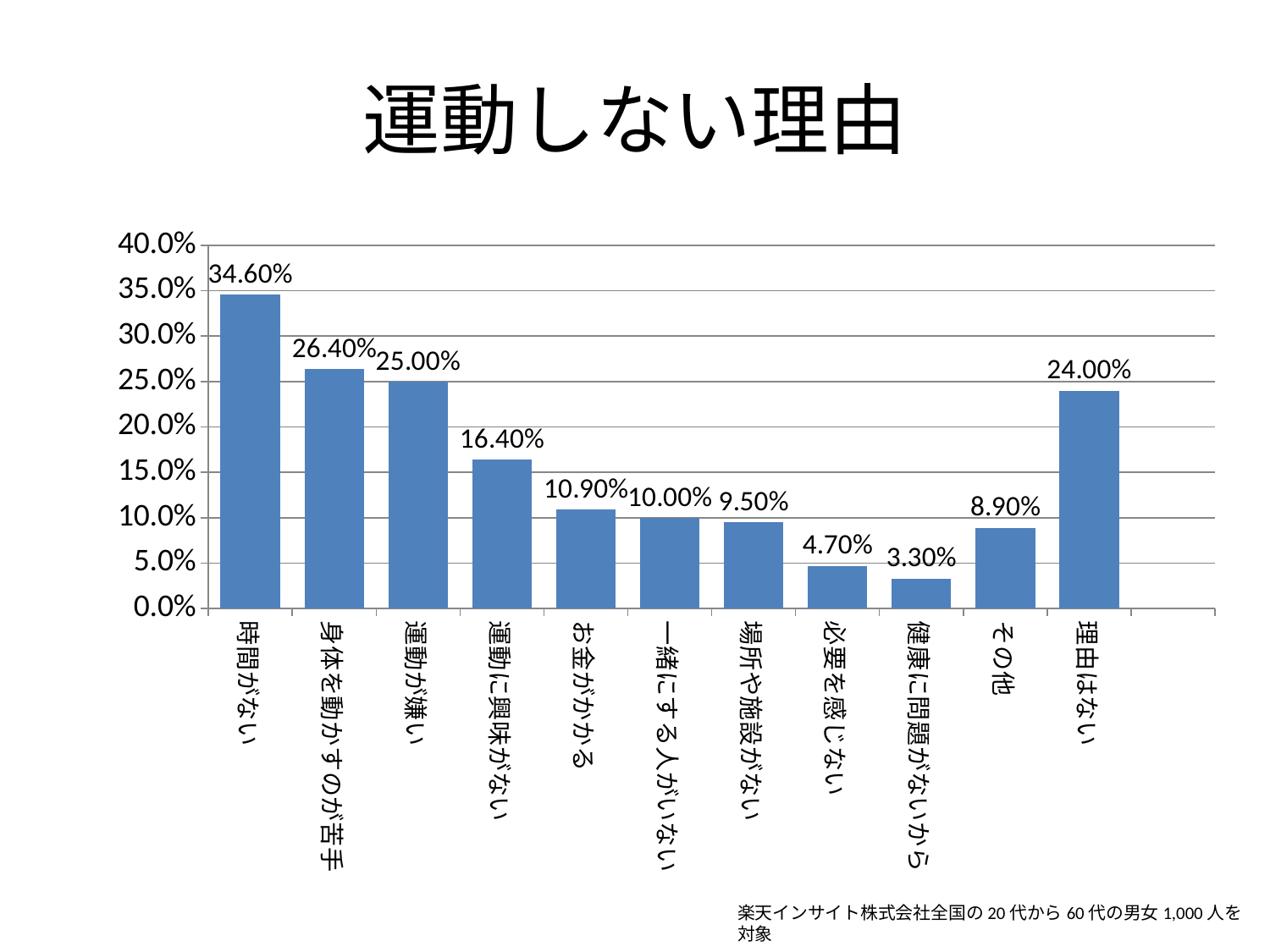
What is the value for 健康に問題がないから? 3.30% What kind of chart is shown on the slide? bar chart What is the value for 理由はない? 24.00% What is the difference between the values for 時間がない and 身体を動かすのが苦手? 8.20% Which is larger, the value for 運動が嫌い or the value for 理由はない? 運動が嫌い Which category has the lowest value? 健康に問題がないから What is the title of the slide? 運動しない理由 How many categories are shown on the x axis? 11 What is the value for 時間がない? 34.60% What is the value for その他? 8.90% Is the value for 運動に興味がない greater or less than 15.0%? greater Which category has the highest value? 時間がない